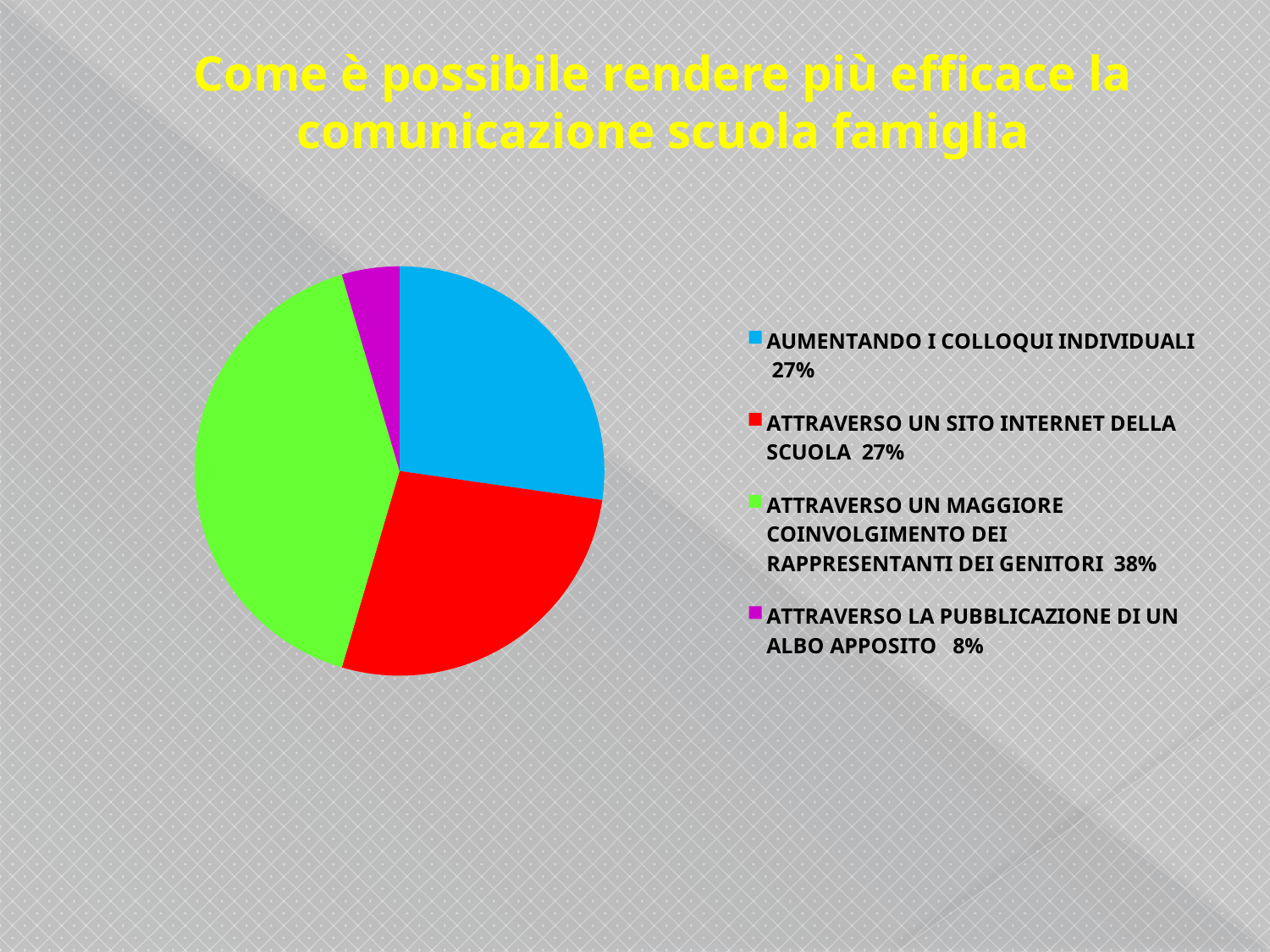
How many slices does the pie chart have? 4 What kind of chart is shown on the slide? Pie chart Which category has the smallest share of the pie? ATTRAVERSO LA PUBBLICAZIONE DI UN ALBO APPOSITO What percentage is shown for 'AUMENTANDO I COLLOQUI INDIVIDUALI'? 27% Which category has the largest share of the pie? ATTRAVERSO UN MAGGIORE COINVOLGIMENTO DEI RAPPRESENTANTI DEI GENITORI What is the difference in percentage points between 'ATTRAVERSO UN MAGGIORE COINVOLGIMENTO DEI RAPPRESENTANTI DEI GENITORI' and 'ATTRAVERSO LA PUBBLICAZIONE DI UN ALBO APPOSITO'? 30 percentage points Which is larger: the share for 'AUMENTANDO I COLLOQUI INDIVIDUALI' or the share for 'ATTRAVERSO LA PUBBLICAZIONE DI UN ALBO APPOSITO'? AUMENTANDO I COLLOQUI INDIVIDUALI What colour is the slice for 'ATTRAVERSO UN SITO INTERNET DELLA SCUOLA'? Red What percentage is shown for 'ATTRAVERSO UN MAGGIORE COINVOLGIMENTO DEI RAPPRESENTANTI DEI GENITORI'? 38% What is the title of the slide containing the pie chart? Come è possibile rendere più efficace la comunicazione scuola famiglia What percentage is shown for 'ATTRAVERSO UN SITO INTERNET DELLA SCUOLA'? 27% What percentage is shown for 'ATTRAVERSO LA PUBBLICAZIONE DI UN ALBO APPOSITO'? 8%